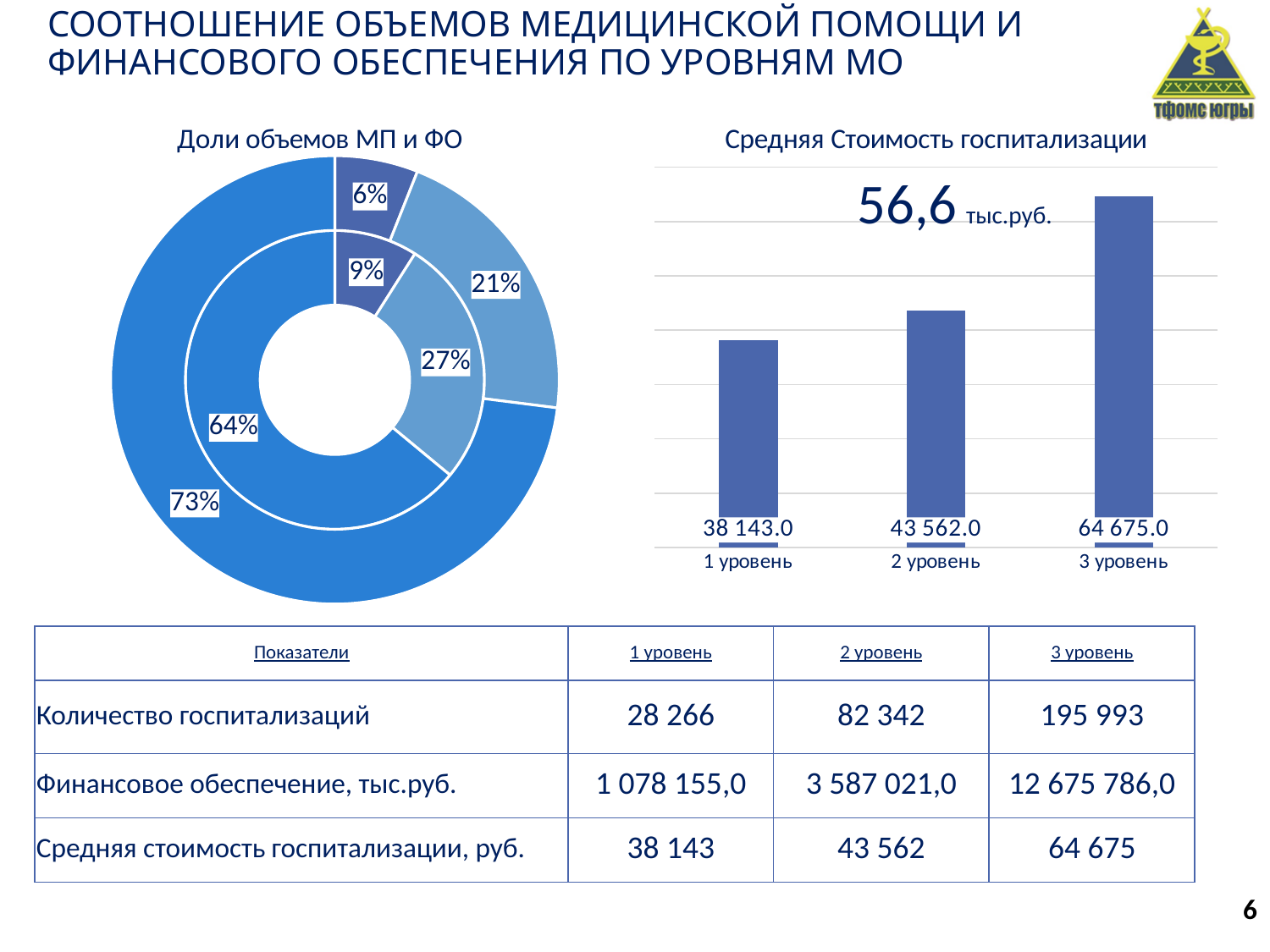
In the chart titled 'Средняя Стоимость госпитализации', what is the value for 2 уровень? 43 562.0 In the chart titled 'Средняя Стоимость госпитализации', which level has the lowest value? 1 уровень In the chart titled 'Средняя Стоимость госпитализации', which is larger: the value for 2 уровень or the value for 1 уровень? 2 уровень In the chart titled 'Доли объемов МП и ФО', what is the smallest percentage shown in the inner ring? 9% In the chart titled 'Доли объемов МП и ФО', what is the largest percentage shown in the outer ring? 73% In the chart titled 'Средняя Стоимость госпитализации', how many bars are plotted? 3 In the chart titled 'Средняя Стоимость госпитализации', what is the value for 3 уровень? 64 675.0 In the chart titled 'Средняя Стоимость госпитализации', which level has the highest value? 3 уровень What kind of chart is the one titled 'Средняя Стоимость госпитализации'? Bar chart In the chart titled 'Средняя Стоимость госпитализации', do the values rise or fall from 1 уровень to 3 уровень? Rise In the chart titled 'Средняя Стоимость госпитализации', what is the value for 1 уровень? 38 143.0 In the chart titled 'Средняя Стоимость госпитализации', what is the difference between the values for 3 уровень and 1 уровень? 26 532.0